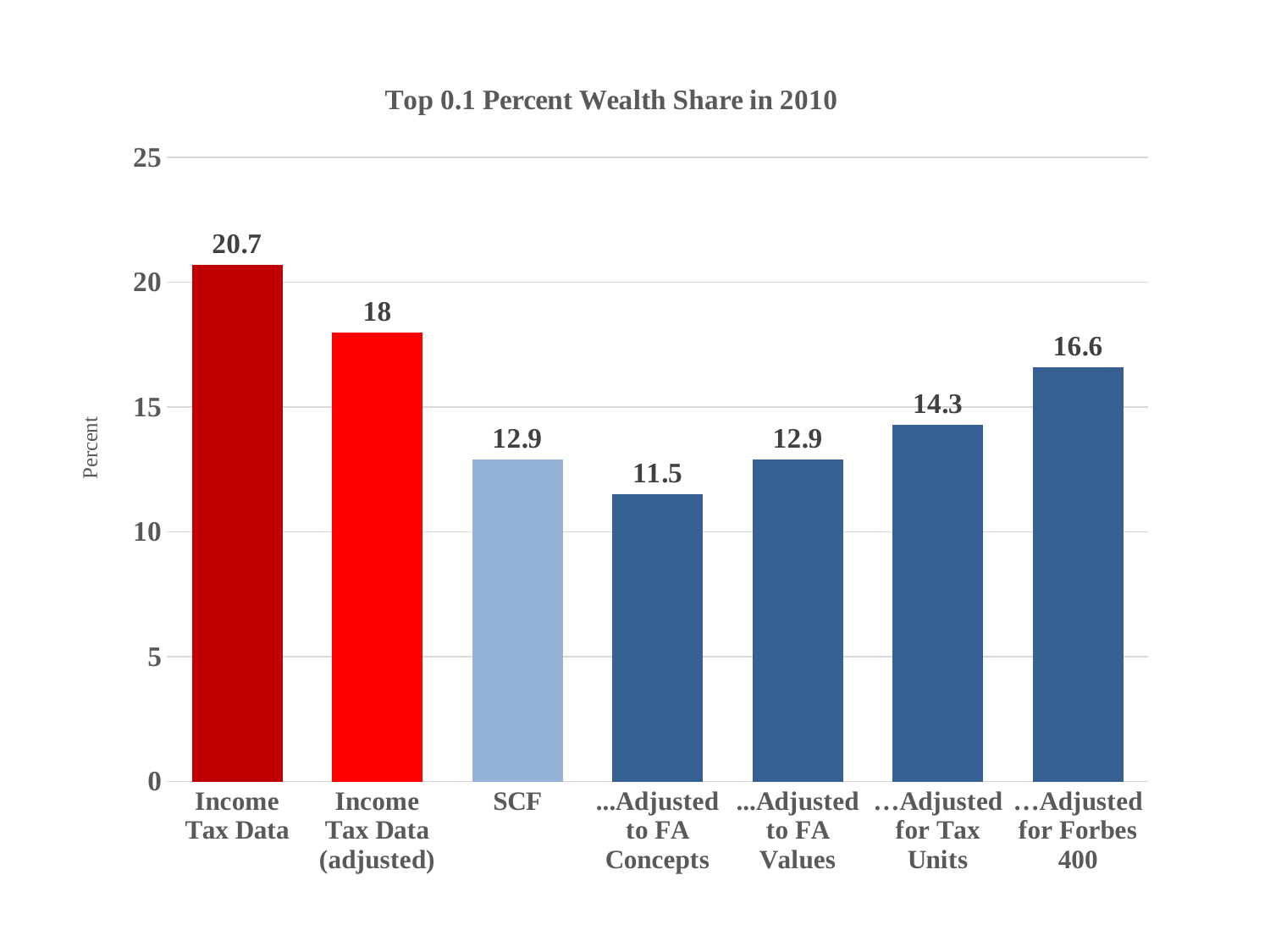
How many categories are shown on the x axis? 7 Which is larger, the value for ...Adjusted for Forbes 400 or the value for ...Adjusted for Tax Units? ...Adjusted for Forbes 400 Which category has the lowest value? ...Adjusted to FA Concepts What is the title of the chart? Top 0.1 Percent Wealth Share in 2010 What is the difference between the values for Income Tax Data and Income Tax Data (adjusted)? 2.7 What is the value for ...Adjusted for Tax Units? 14.3 What is the value for SCF? 12.9 Which category has the highest value? Income Tax Data What is the difference between the values for ...Adjusted for Forbes 400 and ...Adjusted to FA Concepts? 5.1 What is the value for Income Tax Data (adjusted)? 18 What is the value for Income Tax Data? 20.7 What kind of chart is this? bar chart